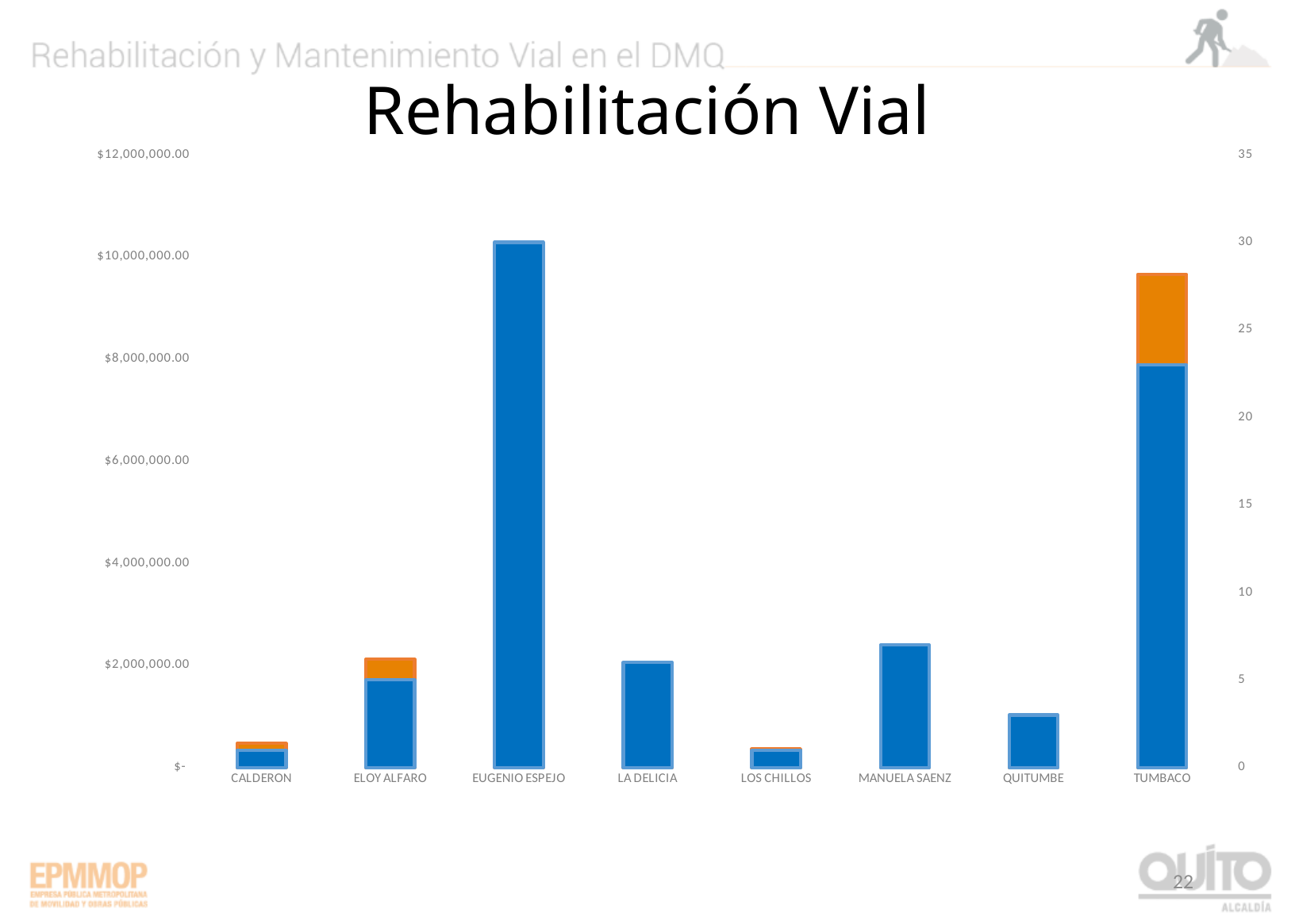
How many categories are shown on the x axis of the chart? 8 Is the total bar for TUMBACO greater or less than $8,000,000.00? greater What is the title of the chart? Rehabilitación Vial Is the total bar for TUMBACO greater or less than $10,000,000.00? less Which bar is taller, EUGENIO ESPEJO or TUMBACO? EUGENIO ESPEJO Which bar is taller, MANUELA SAENZ or QUITUMBE? MANUELA SAENZ Which category has the tallest bar in the chart? EUGENIO ESPEJO Is the value for QUITUMBE greater or less than $2,000,000.00? less What kind of chart is shown on the slide? bar chart